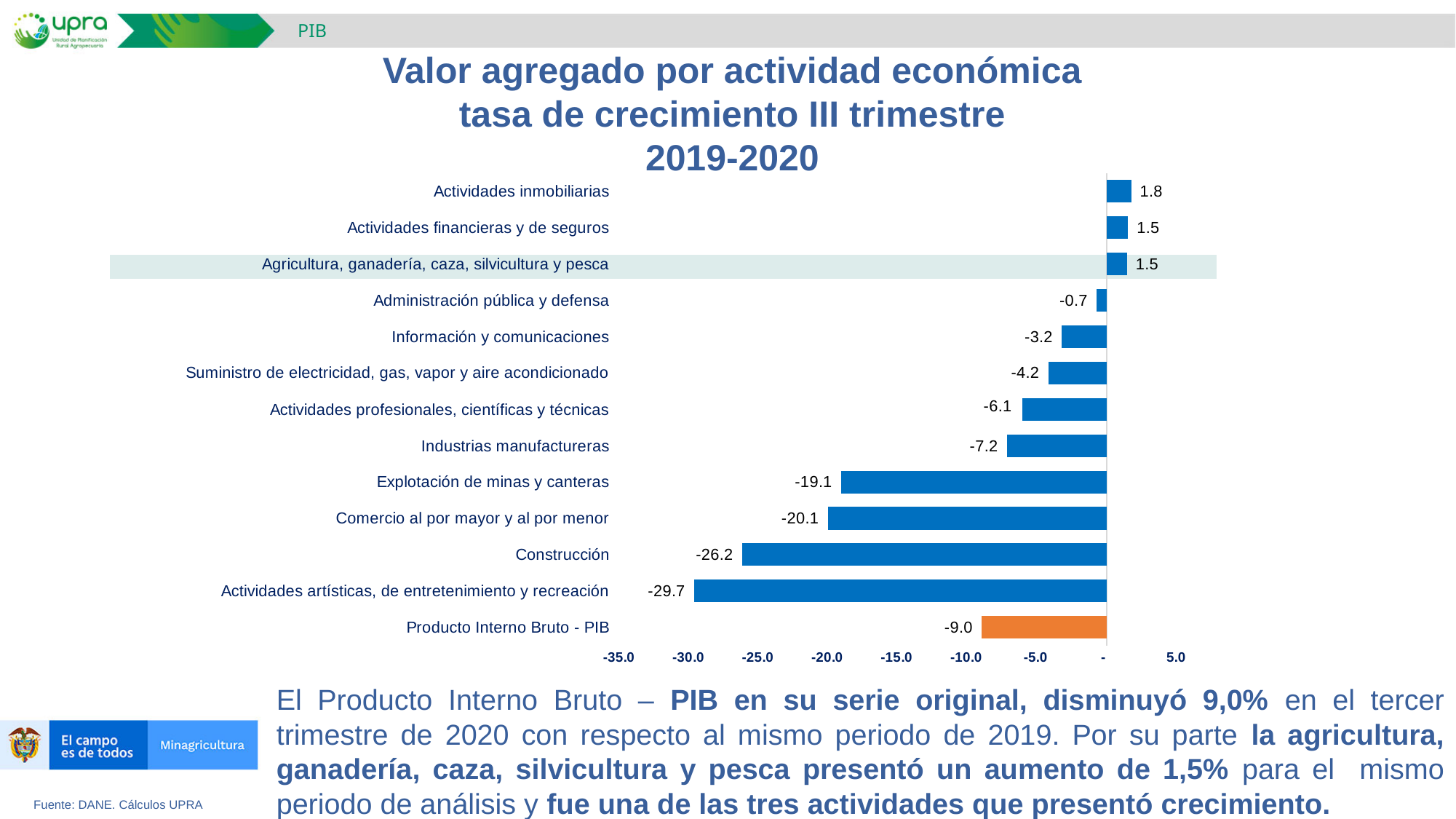
Which category has the lowest value? Actividades artísticas, de entretenimiento y recreación How many categories are shown in the chart? 13 Which bar is shown in orange rather than blue? Producto Interno Bruto - PIB How many categories have a positive value? 3 What kind of chart is shown on the slide? Bar chart What is the value for Agricultura, ganadería, caza, silvicultura y pesca? 1.5 What is the difference between the values for Comercio al por mayor y al por menor and Explotación de minas y canteras? 1.0 Which is larger, the value for Industrias manufactureras or the value for Información y comunicaciones? Información y comunicaciones What is the value for Actividades inmobiliarias? 1.8 What is the value for Construcción? -26.2 What is the value for Producto Interno Bruto - PIB? -9.0 Which category has the highest value? Actividades inmobiliarias